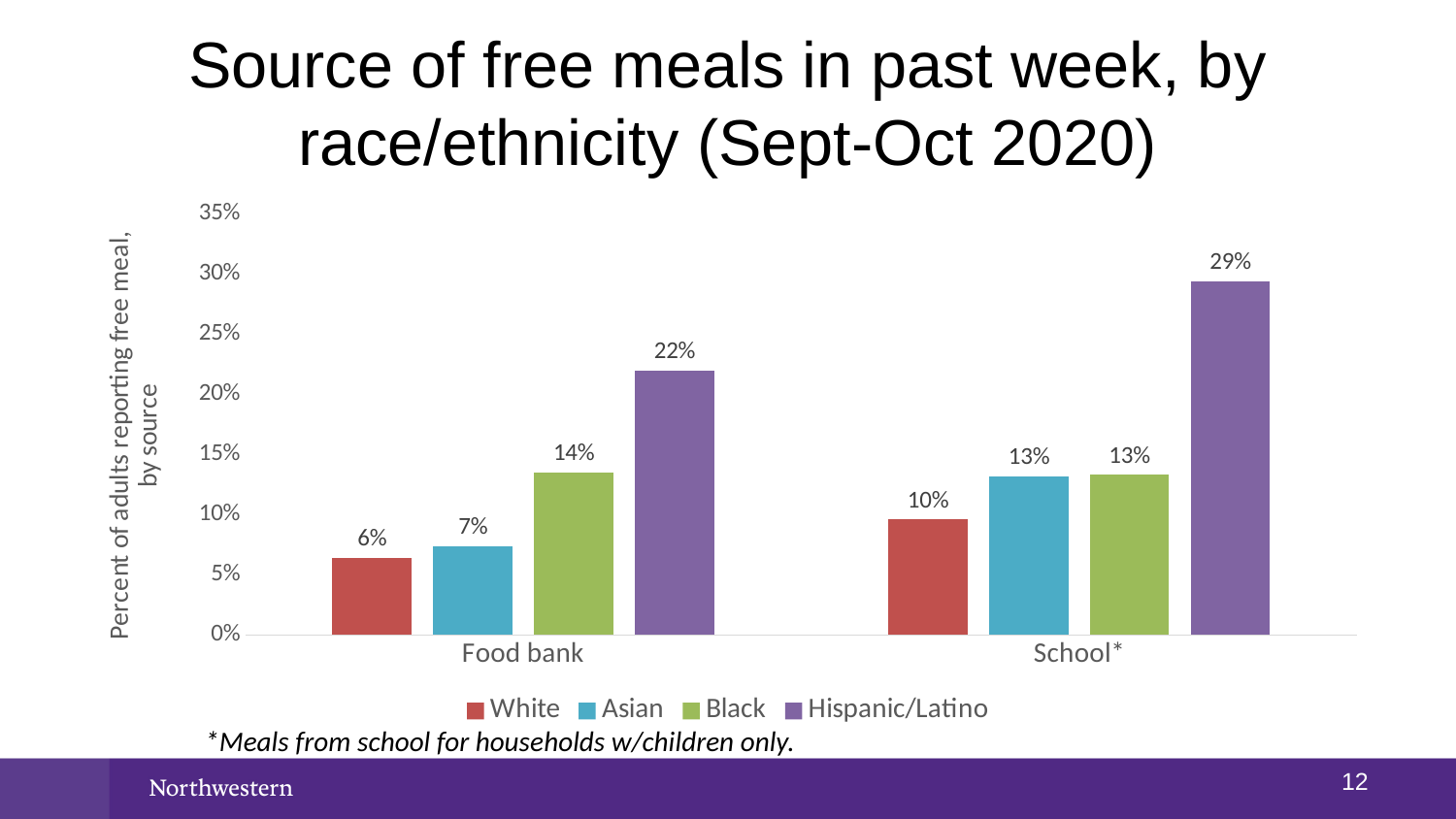
What percent of Hispanic/Latino adults reported a free meal from a food bank? 22% What is the difference between the Hispanic/Latino values for School* and Food bank? 7% What kind of chart is shown on the slide? Bar chart Which race/ethnicity group has the highest value for School*? Hispanic/Latino What percent of Black adults reported a free meal from a food bank? 14% How many source categories are shown on the x axis? 2 What is the label of the y axis? Percent of adults reporting free meal, by source Which is larger: the Asian value for Food bank or the Asian value for School*? School* Is the Hispanic/Latino value for School* greater or less than 25%? greater Which race/ethnicity group has the lowest value for Food bank? White How many series does the legend list? 4 What percent of White adults reported a free meal from school? 10%